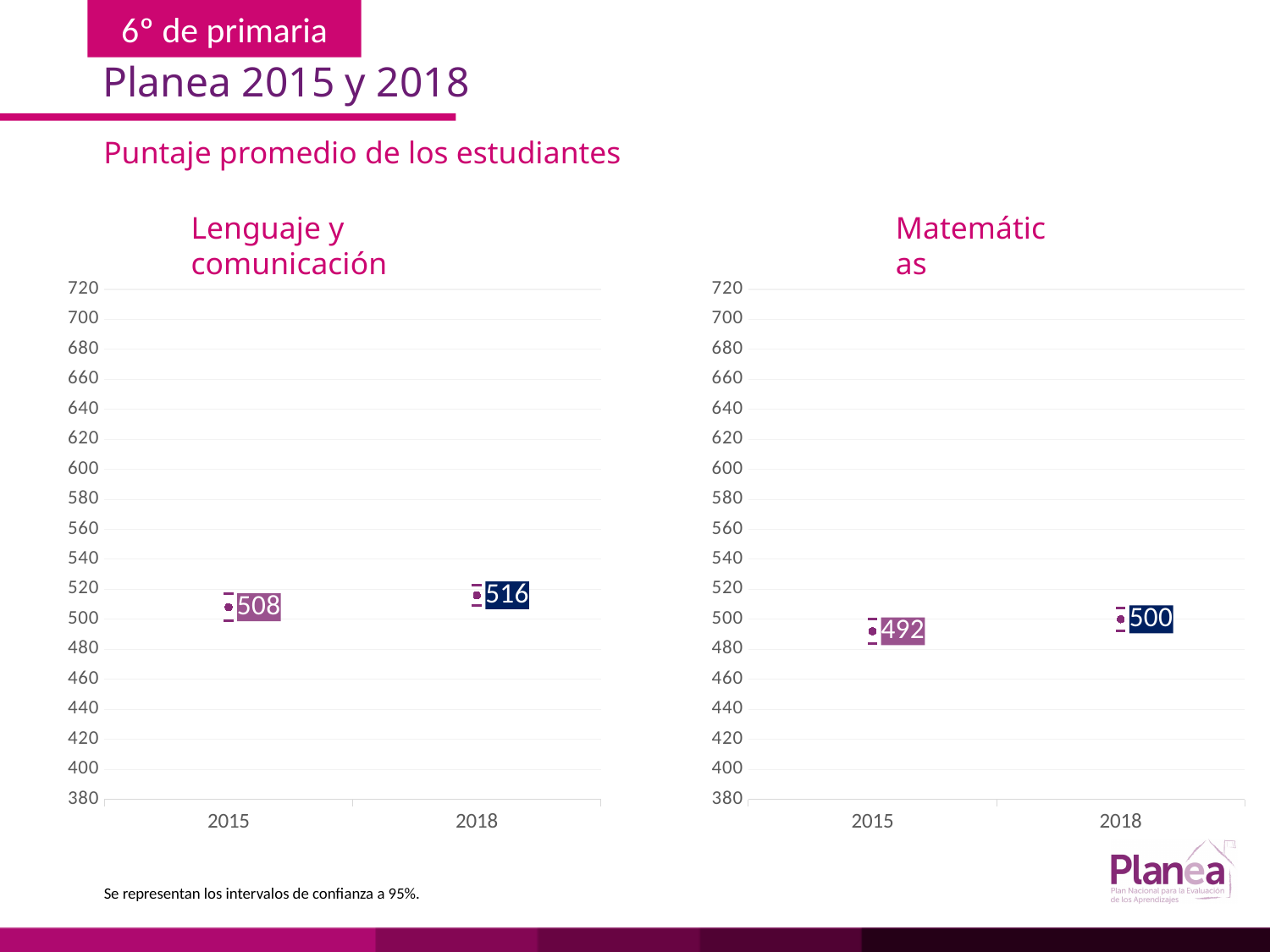
In the 'Matemáticas' chart, do the scores rise or fall from 2015 to 2018? rise How many years are plotted on the x axis of the 'Lenguaje y comunicación' chart? 2 What is the highest value shown on the y axis of the 'Matemáticas' chart? 720 In the 'Lenguaje y comunicación' chart, which year has the lowest score? 2015 In the 'Lenguaje y comunicación' chart, what is the average score for 2015? 508 In the 'Matemáticas' chart, is the 2015 score greater or less than 500? less In the 'Matemáticas' chart, what is the average score for 2018? 500 In the 'Matemáticas' chart, what is the difference between the 2018 and 2015 scores? 8 In the 'Matemáticas' chart, what is the average score for 2015? 492 In the 'Matemáticas' chart, which year has the higher score, 2015 or 2018? 2018 In the 'Lenguaje y comunicación' chart, what is the average score for 2018? 516 In the 'Lenguaje y comunicación' chart, by how many points did the score change from 2015 to 2018? 8